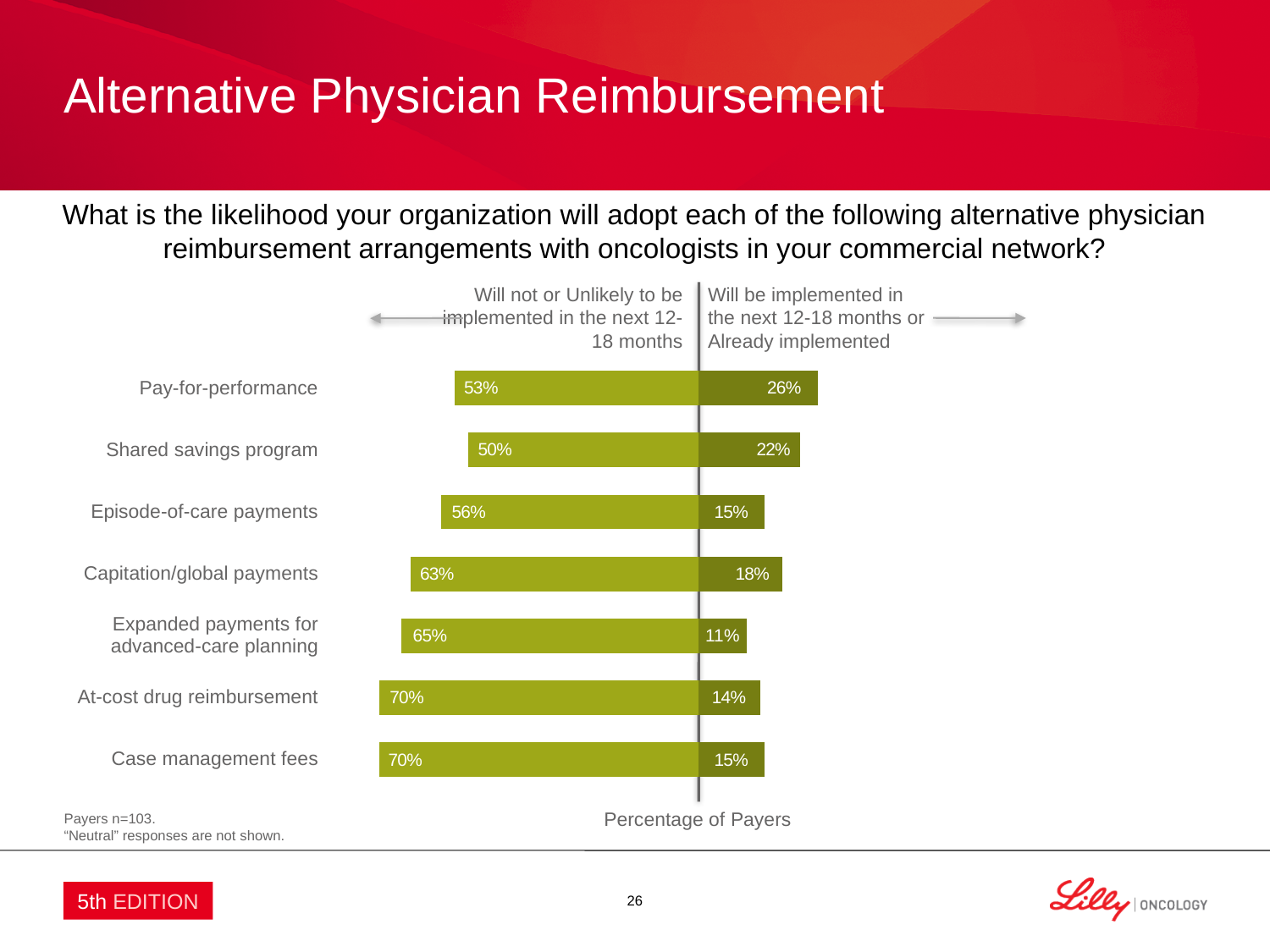
How many reimbursement arrangements are shown in the chart? 7 How many response categories (series) does the chart show for each arrangement? 2 Which has a higher 'will be implemented or already implemented' percentage: shared savings program or episode-of-care payments? Shared savings program What percentage of payers say expanded payments for advanced-care planning will be implemented in the next 12-18 months or is already implemented? 11% Which arrangement has the lowest percentage of payers saying it will be implemented in the next 12-18 months or is already implemented? Expanded payments for advanced-care planning What percentage of payers say case management fees will not or are unlikely to be implemented in the next 12-18 months? 70% What type of chart is shown on the slide? Bar chart What is the difference between the 'will not or unlikely' percentage and the 'will be implemented or already implemented' percentage for capitation/global payments? 45% Which arrangement has the highest percentage of payers saying it will be implemented in the next 12-18 months or is already implemented? Pay-for-performance What is the sample size of payers noted on the slide? n=103 What percentage of payers say pay-for-performance will be implemented in the next 12-18 months or is already implemented? 26% Which arrangement has the lowest percentage of payers saying it will not or is unlikely to be implemented in the next 12-18 months? Shared savings program